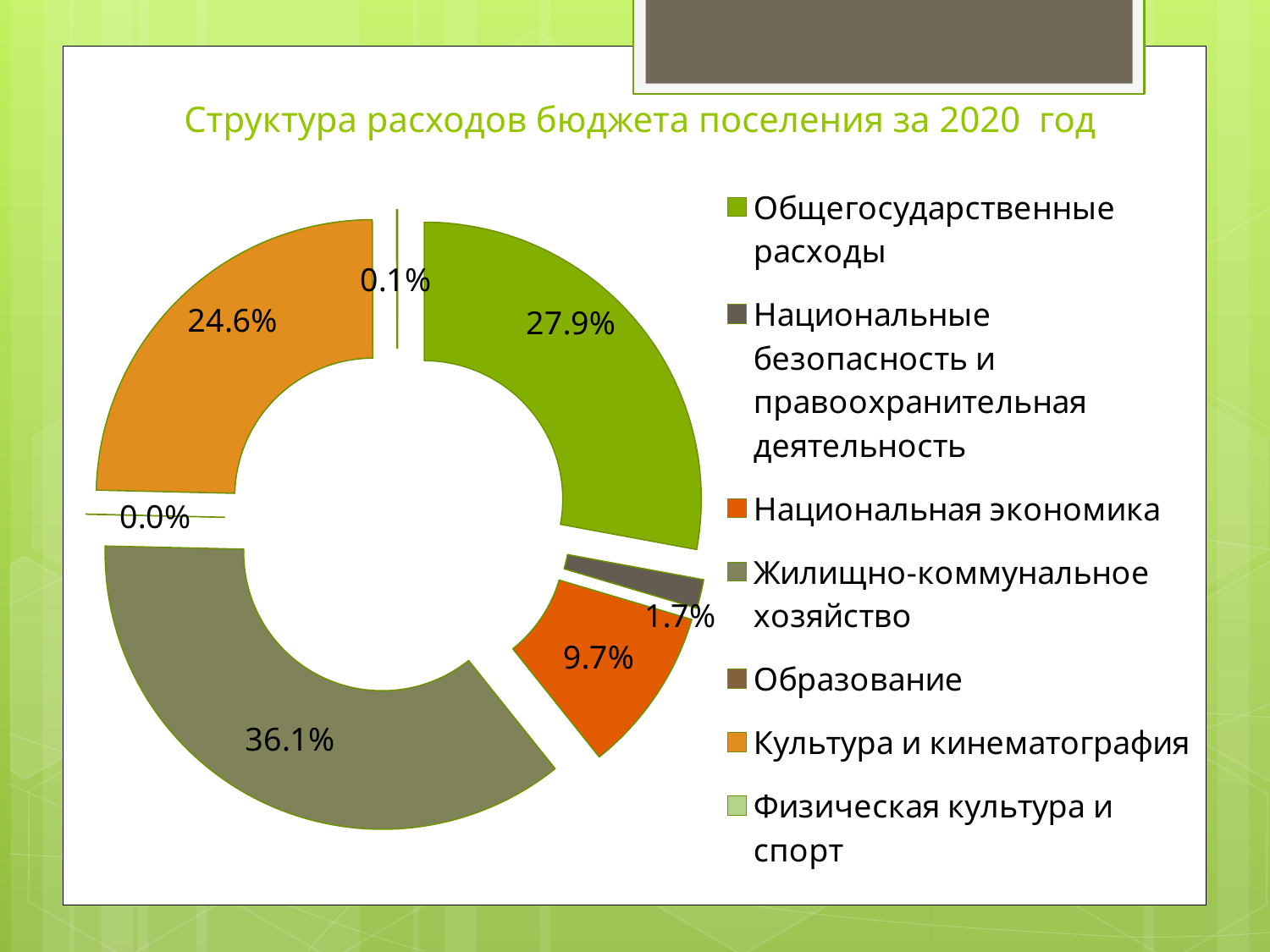
Which category has the smallest share of the budget expenses? Образование Which category has the largest share of the budget expenses? Жилищно-коммунальное хозяйство What share is shown for Национальные безопасность и правоохранительная деятельность? 1.7% What is the title of the chart? Структура расходов бюджета поселения за 2020 год What share of the budget expenses goes to Общегосударственные расходы? 27.9% How many entries does the legend list? 7 What is the difference between the shares of Жилищно-коммунальное хозяйство and Общегосударственные расходы? 8.2% What share of the budget expenses goes to Национальная экономика? 9.7% What kind of chart is shown on the slide? Doughnut (pie) chart What share is shown for Образование? 0.0% What share of the budget expenses goes to Жилищно-коммунальное хозяйство? 36.1% What share of the budget expenses goes to Культура и кинематография? 24.6%